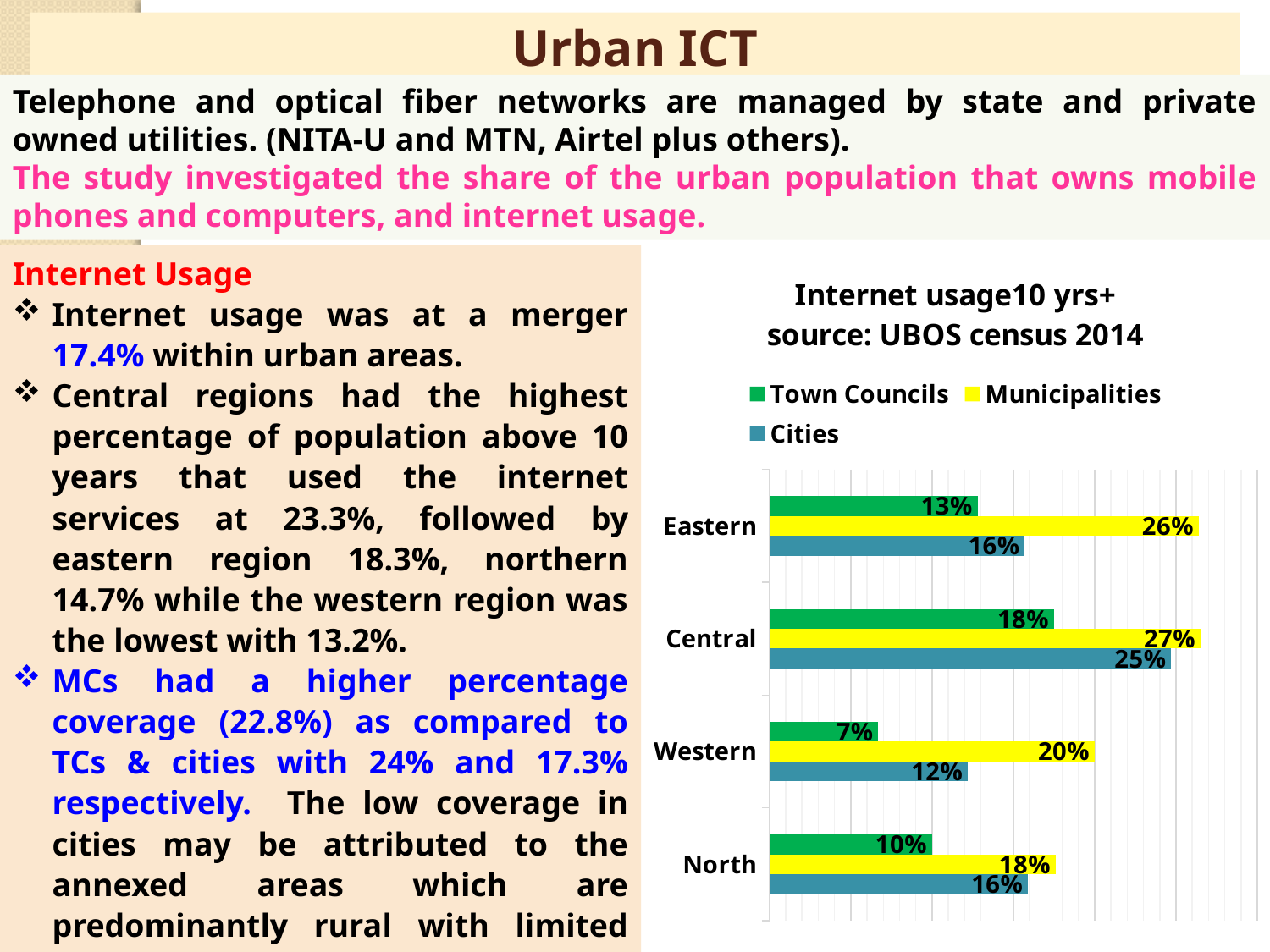
What kind of chart is shown on the slide? Bar chart How many regions are shown on the chart? 4 Which is larger for North: the Town Councils value or the Cities value? Cities Which series is shown in yellow in the chart? Municipalities Which region has the lowest Town Councils value? Western What is the Municipalities value for North? 18% How many series does the chart legend list? 3 What is the difference between the Municipalities and Cities values for Eastern? 10% What is the Town Councils value for Western? 7% Which region has the highest Municipalities value? Central What is the Municipalities value for Eastern? 26% What is the Cities value for Central? 25%